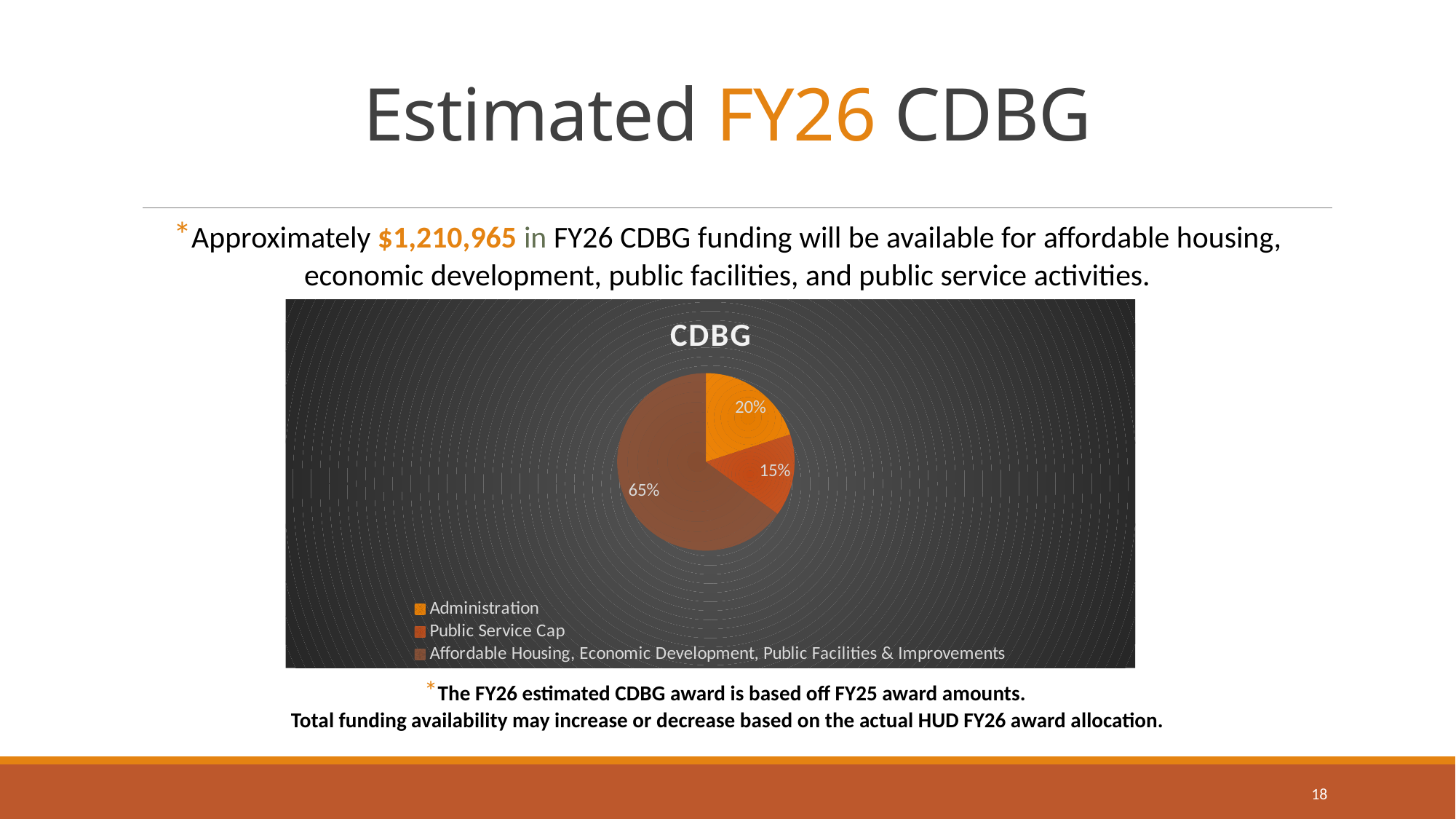
What is the difference in percentage points between the largest slice and the Administration slice? 45% How many categories does the pie chart show? 3 What kind of chart is shown on the slide? Pie chart How many entries does the chart legend list? 3 What is the difference in percentage points between the Administration slice and the Public Service Cap slice? 5% What share of the pie does Public Service Cap represent? 15% What is the title of the chart? CDBG What share of the pie does Affordable Housing, Economic Development, Public Facilities & Improvements represent? 65% Which category has the smallest slice of the pie? Public Service Cap Which is larger, the Administration slice or the Public Service Cap slice? Administration Which category has the largest slice of the pie? Affordable Housing, Economic Development, Public Facilities & Improvements What share of the pie does Administration represent? 20%